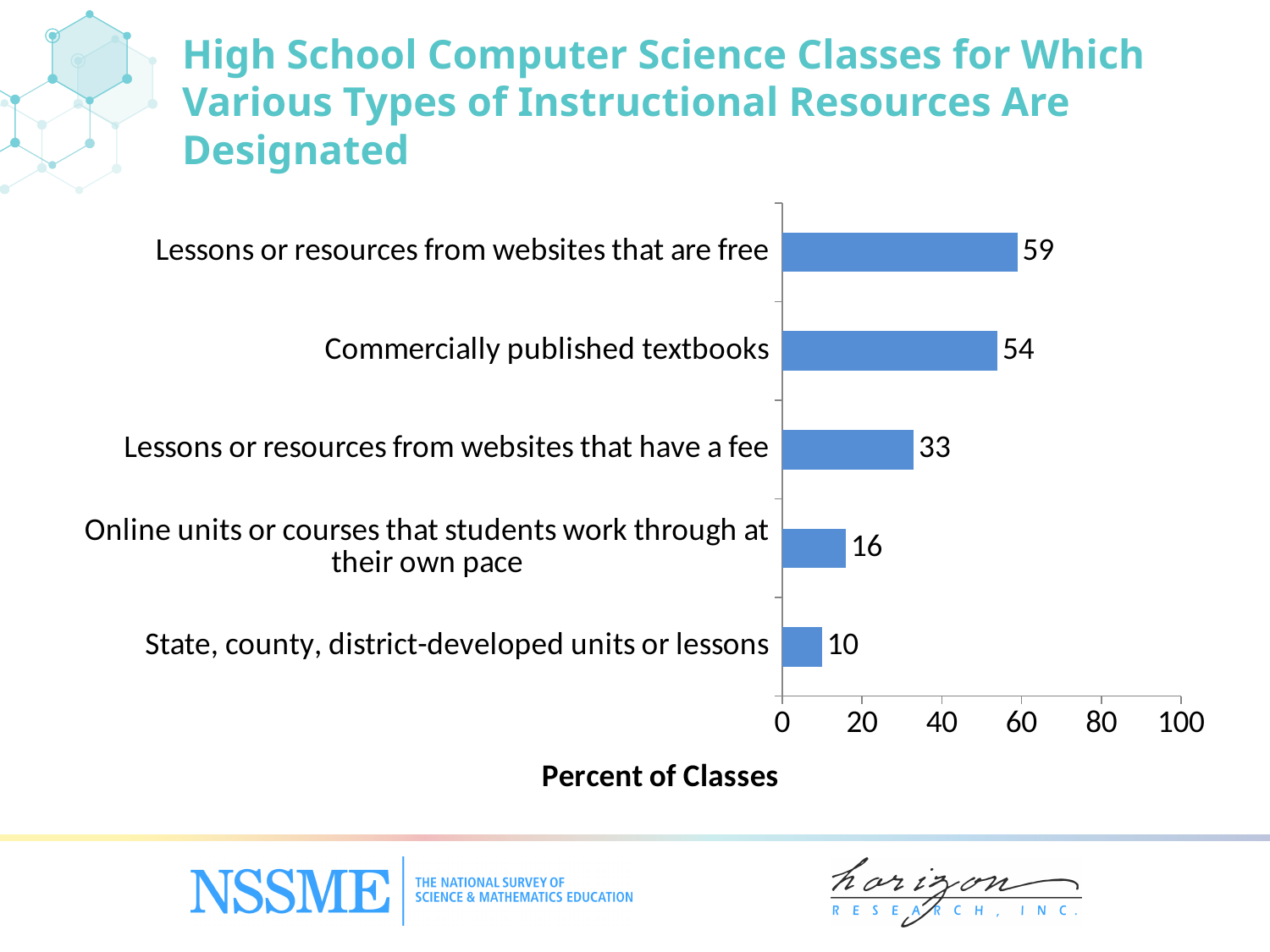
How many categories are shown in the chart? 5 Is the value for commercially published textbooks greater or less than 40? greater What is the difference between the values for commercially published textbooks and state, county, district-developed units or lessons? 44 What is the value for commercially published textbooks? 54 Which category has the lowest percent of classes? State, county, district-developed units or lessons What percent of classes designate lessons or resources from websites that are free? 59 What is the label of the horizontal axis? Percent of Classes What kind of chart is shown on the slide? Bar chart What is the difference between the values for lessons or resources from websites that are free and lessons or resources from websites that have a fee? 26 Which is larger: the value for lessons or resources from websites that have a fee or the value for online units or courses that students work through at their own pace? Lessons or resources from websites that have a fee What percent of classes designate online units or courses that students work through at their own pace? 16 Which category has the highest percent of classes? Lessons or resources from websites that are free